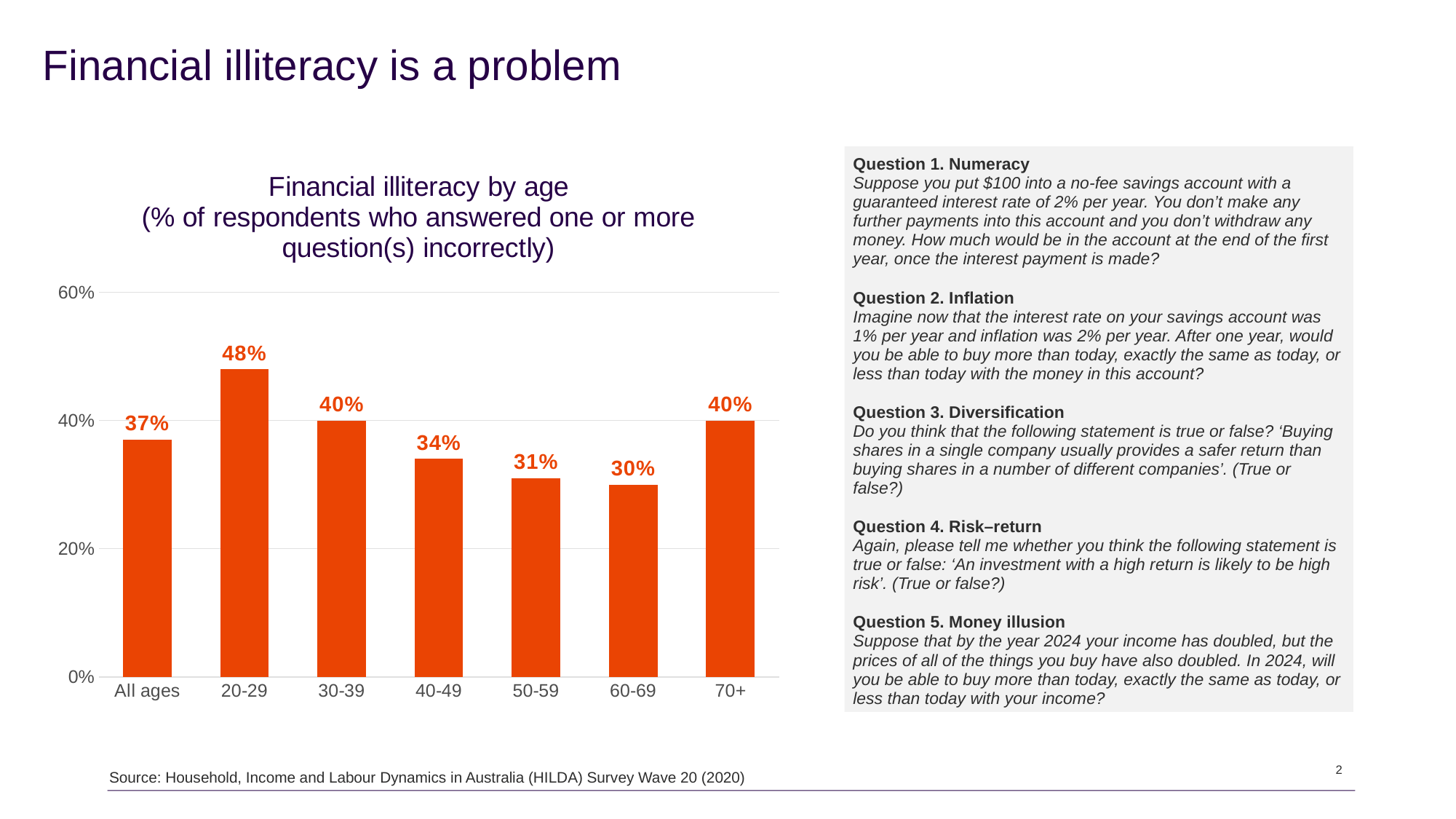
What is the title of the chart? Financial illiteracy by age (% of respondents who answered one or more question(s) incorrectly) Which is larger, the value for 30-39 or the value for 40-49? 30-39 What is the difference between the values for 20-29 and 60-69? 18% What is the value for All ages? 37% How many categories are shown on the x axis? 7 What is the difference between the values for 40-49 and 50-59? 3% Is the value for 70+ greater or less than 20%? greater Which age group has the lowest percentage of respondents answering one or more questions incorrectly? 60-69 What kind of chart is shown on the slide? Bar chart What is the value for the 20-29 age group? 48% What is the value for the 60-69 age group? 30% Which age group has the highest percentage of respondents answering one or more questions incorrectly? 20-29